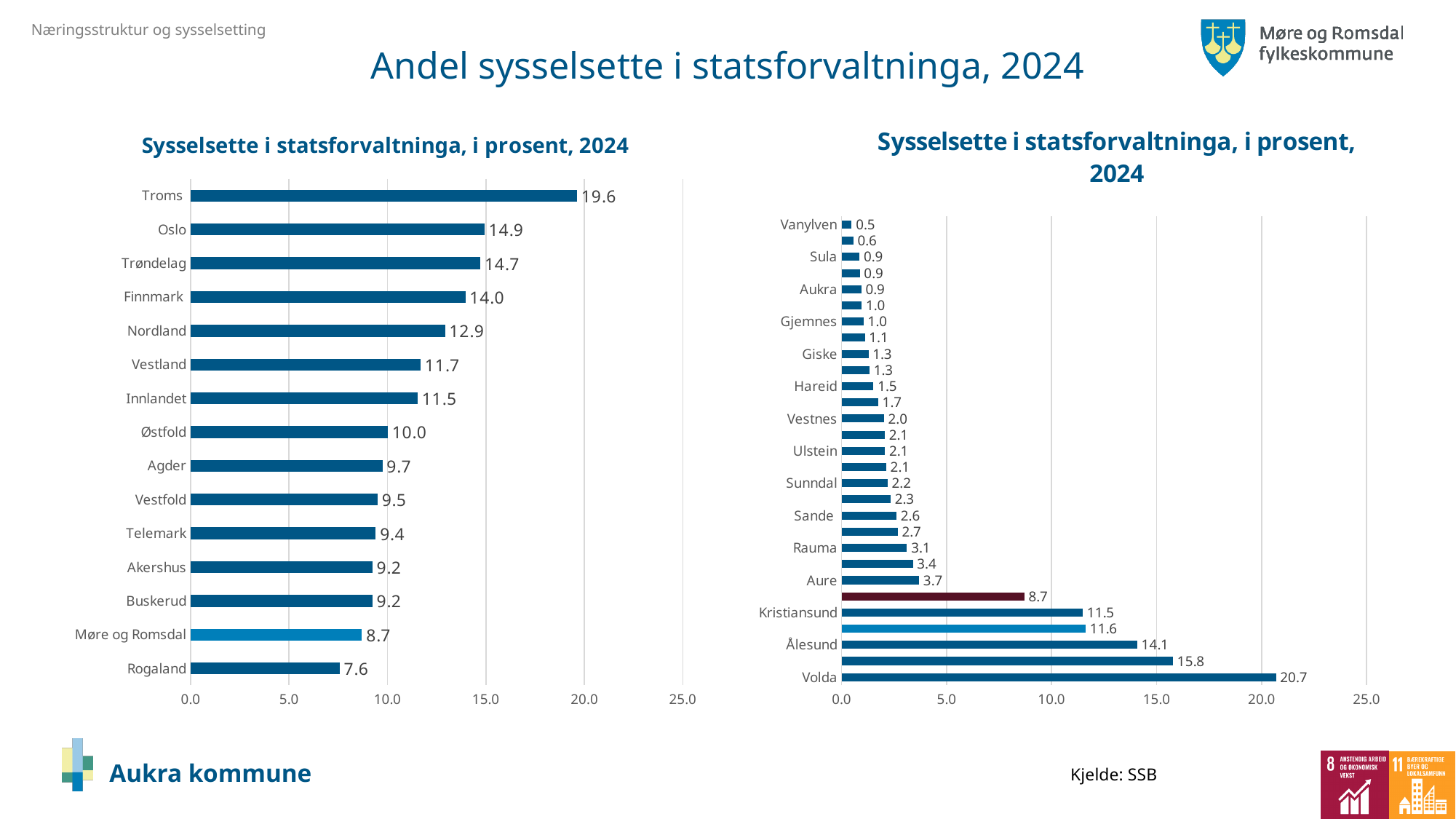
On the right chart, what is the value for Kristiansund? 11.5 On the left chart, what is the value for Møre og Romsdal? 8.7 On the left chart, what is the value for Troms? 19.6 How many counties are shown on the left chart? 15 On the left chart, which is larger, Nordland or Vestland? Nordland On the left chart, what is the difference between Oslo and Trøndelag? 0.2 On the right chart, which bar is coloured dark red rather than blue? The 8.7 bar What type of chart is the left chart? Bar chart On the right chart, what is the difference between Ålesund and Aure? 10.4 On the right chart, what is the value for Volda? 20.7 On the left chart, which county has the lowest value? Rogaland On the right chart, which municipality has the highest value? Volda